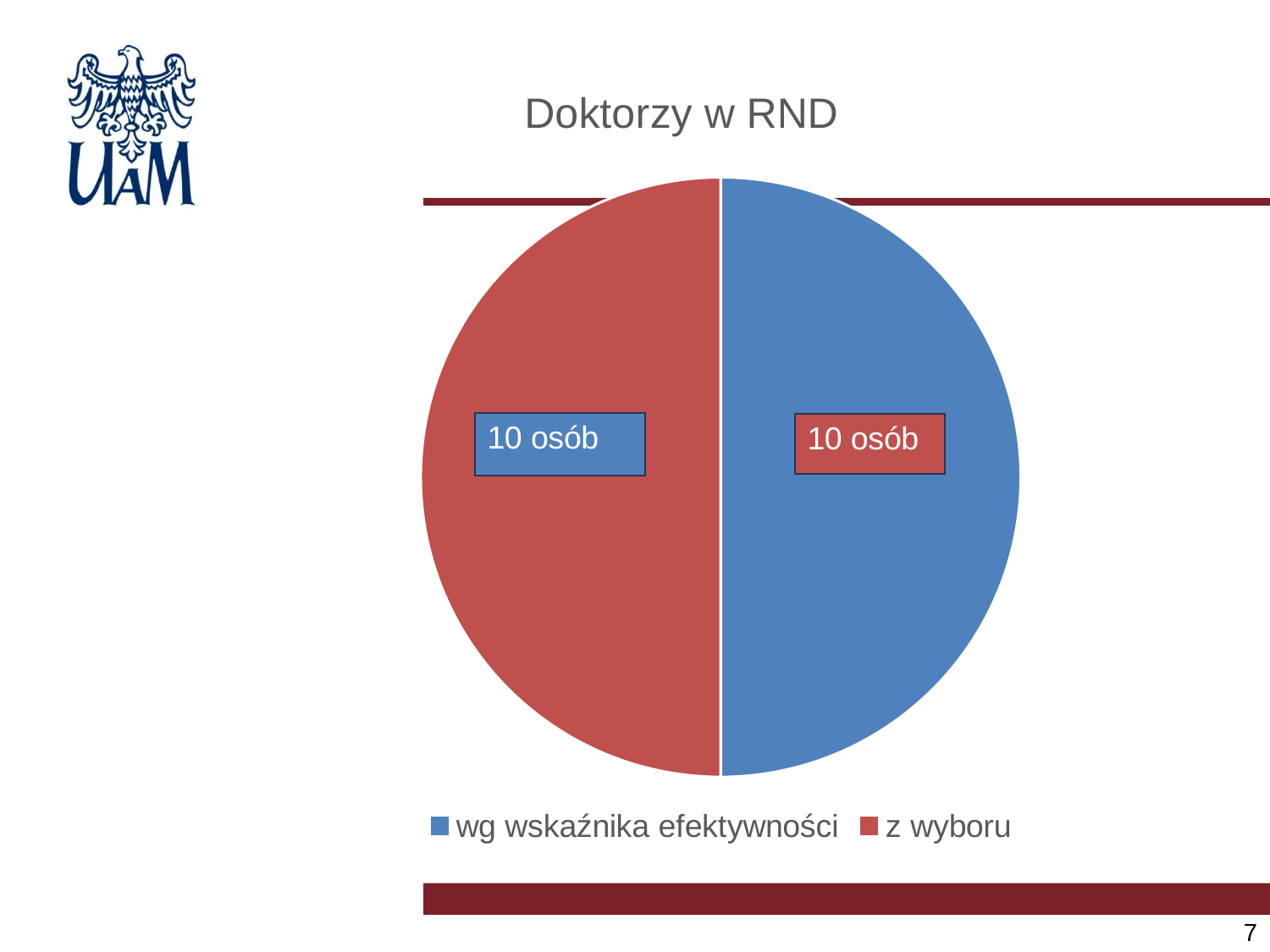
How many slices does the pie chart have? 2 Which colour represents 'z wyboru' in the legend? red How many entries does the legend list? 2 What value is shown for the 'z wyboru' slice? 10 osób What share of the pie does the 'wg wskaźnika efektywności' slice represent? 50% What kind of chart is shown on the slide? pie chart What is the difference between the 'wg wskaźnika efektywności' and 'z wyboru' values? 0 What value is shown for the 'wg wskaźnika efektywności' slice? 10 osób What share of the pie does the 'z wyboru' slice represent? 50% What is the title of the chart? Doktorzy w RND What is the total number of people represented in the pie chart? 20 osób